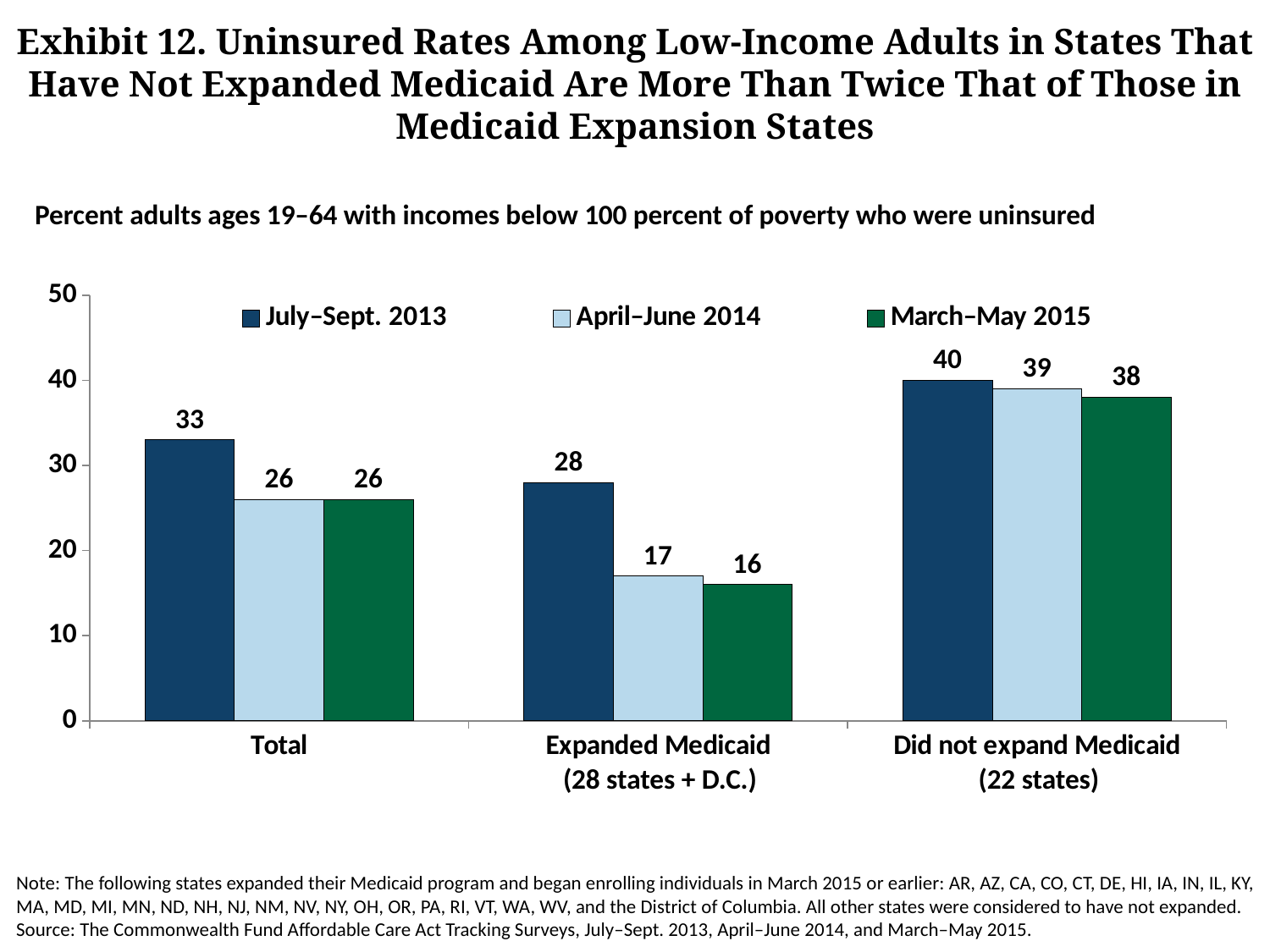
By how many points did the uninsured rate for Expanded Medicaid states fall from July–Sept. 2013 to March–May 2015? 12 Did the uninsured rate for states that did not expand Medicaid rise or fall from July–Sept. 2013 to March–May 2015? Fall What was the uninsured rate for Expanded Medicaid states in March–May 2015? 16 How many series does the legend list? 3 What was the uninsured rate for the Total group in July–Sept. 2013? 33 What was the uninsured rate for states that did not expand Medicaid in April–June 2014? 39 What kind of chart is shown on the slide? Bar chart Which category had the lowest uninsured rate in March–May 2015? Expanded Medicaid (28 states + D.C.) How many categories are shown on the x axis? 3 What is the difference between the March–May 2015 uninsured rates for states that did not expand Medicaid and states that expanded Medicaid? 22 Which is larger: the Total uninsured rate in April–June 2014 or the Expanded Medicaid uninsured rate in April–June 2014? Total Which category had the highest uninsured rate in July–Sept. 2013? Did not expand Medicaid (22 states)